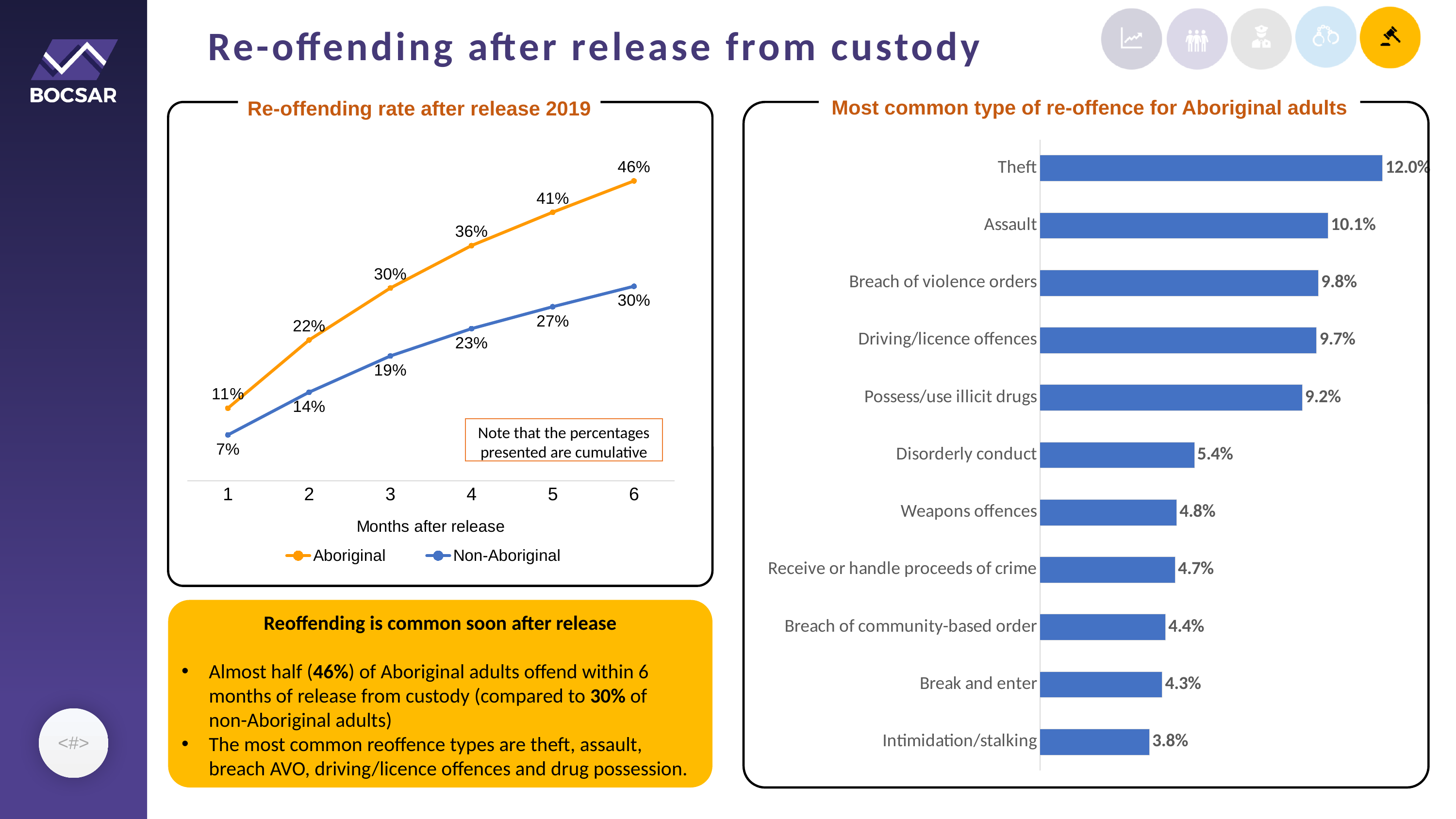
In the 'Most common type of re-offence for Aboriginal adults' chart, which category has the lowest value? Intimidation/stalking In the 'Re-offending rate after release 2019' chart, what is the difference between the Aboriginal and Non-Aboriginal rates at 6 months after release? 16% In the 'Re-offending rate after release 2019' chart, what is the re-offending rate for Non-Aboriginal adults at 3 months after release? 19% In the 'Re-offending rate after release 2019' chart, do the values for Aboriginal adults rise or fall as months after release increase? rise In the 'Most common type of re-offence for Aboriginal adults' chart, what is the value for Assault? 10.1% In the 'Re-offending rate after release 2019' chart, what is the re-offending rate for Aboriginal adults at 6 months after release? 46% In the 'Re-offending rate after release 2019' chart, how many series does the legend list? 2 In the 'Most common type of re-offence for Aboriginal adults' chart, what is the difference between Theft and Disorderly conduct? 6.6% What kind of chart is the 'Re-offending rate after release 2019' chart? line chart In the 'Most common type of re-offence for Aboriginal adults' chart, how many categories are shown? 11 In the 'Most common type of re-offence for Aboriginal adults' chart, which category has the highest value? Theft What kind of chart is the 'Most common type of re-offence for Aboriginal adults' chart? bar chart